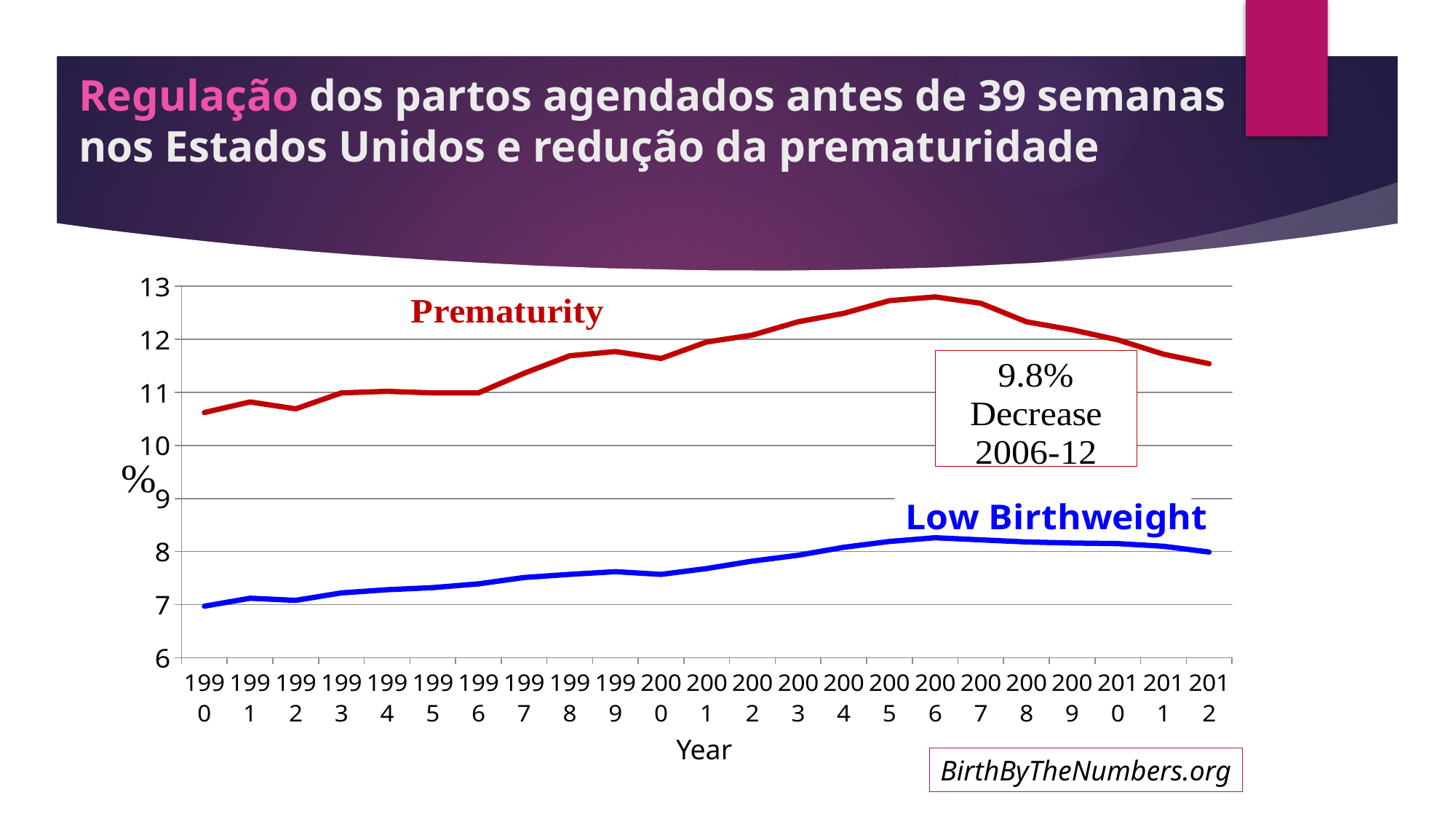
What kind of chart is shown on the slide? line chart Is the Prematurity value for 2012 greater or less than 11? greater How many years are shown along the x axis of the chart? 23 Is the Prematurity value for 1990 greater or less than 11? less Is the Low Birthweight value for 1990 greater or less than 8? less In 2006, which series has the larger value, Prematurity or Low Birthweight? Prematurity Does the Prematurity line rise or fall from 2006 to 2012? fall In which year does the Prematurity line reach its highest value? 2006 How many series are plotted on the chart? 2 What decrease does the text box on the chart report for 2006-12? 9.8%